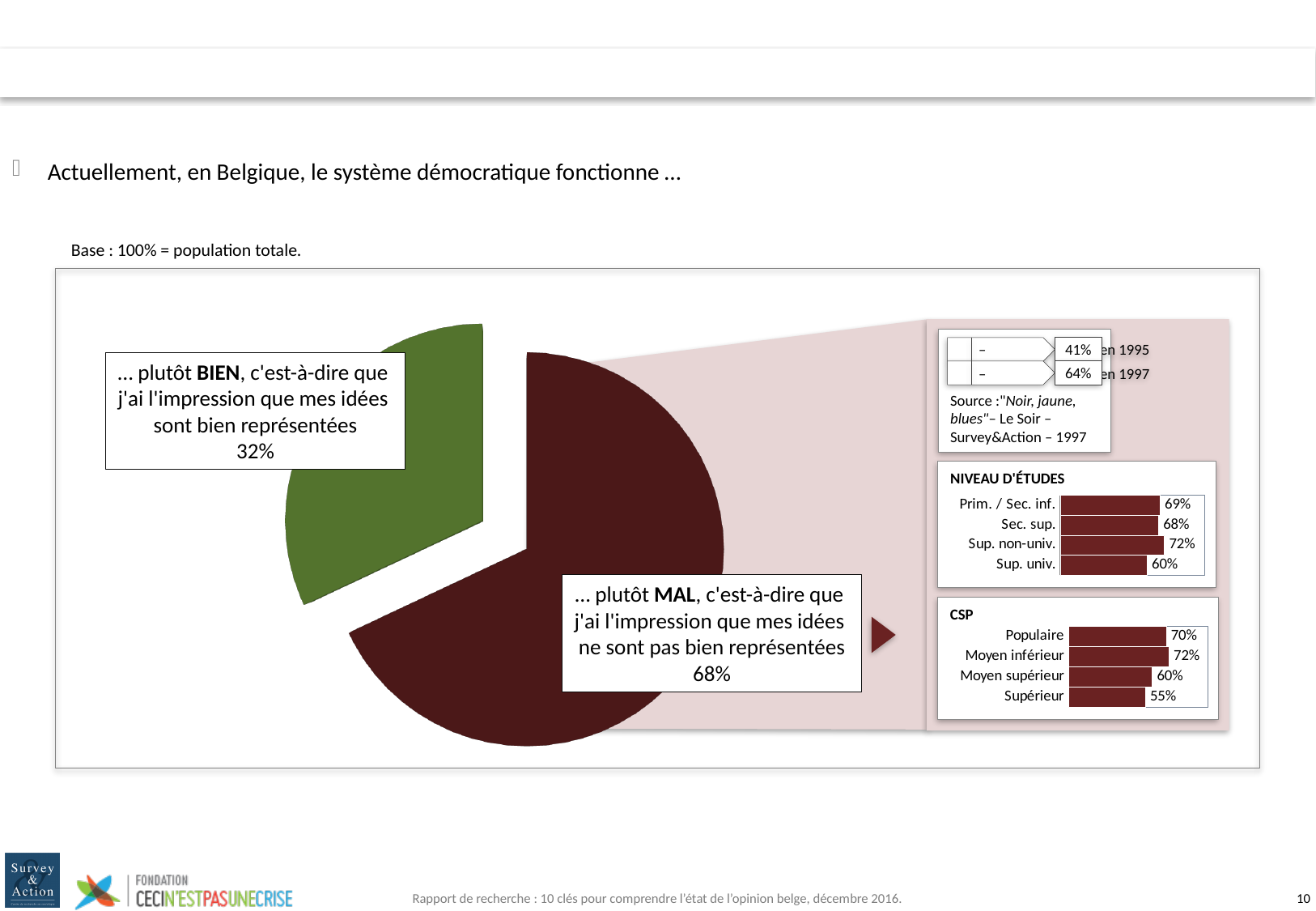
In the pie chart, which of the two slices is larger, 'plutôt BIEN' or 'plutôt MAL'? plutôt MAL In the pie chart, what share of respondents say the democratic system works 'plutôt BIEN'? 32% In the pie chart, what share of respondents say the democratic system works 'plutôt MAL'? 68% How many categories are shown in the CSP bar chart? 4 What kind of chart is the large chart on the left of the slide? Pie chart How many slices does the pie chart have? 2 In the CSP bar chart, which category has the highest value? Moyen inférieur In the NIVEAU D'ÉTUDES bar chart, what is the value for 'Sup. non-univ.'? 72% In the NIVEAU D'ÉTUDES bar chart, which category has the lowest value? Sup. univ. In the pie chart, what is the difference between the 'plutôt MAL' share and the 'plutôt BIEN' share? 36 percentage points In the CSP bar chart, what is the value for 'Supérieur'? 55% In the NIVEAU D'ÉTUDES bar chart, what is the difference between 'Prim. / Sec. inf.' and 'Sup. univ.'? 9 percentage points